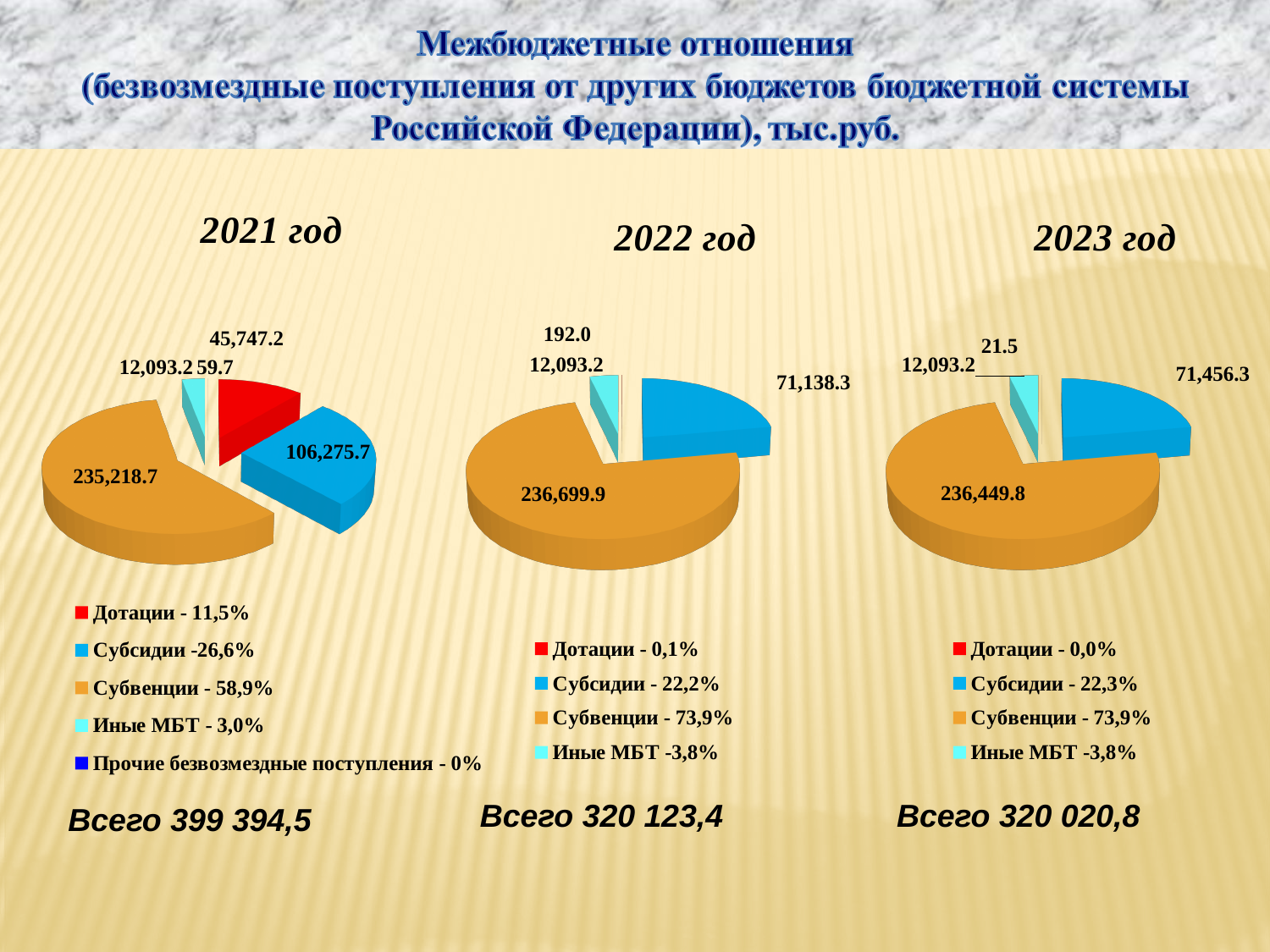
What type of charts are shown on the slide? Pie charts How many categories does the legend of the 2021 год chart list? 5 In the 2021 год chart, what is the value for Субсидии? 106,275.7 In the 2022 год chart, what share of the pie does Субвенции represent according to the legend? 73,9% In the 2023 год chart, what is the value for Субсидии? 71,456.3 In the 2021 год chart, which is larger: Дотации or Субсидии? Субсидии In the 2022 год chart, what is the value for Дотации? 192.0 In the 2021 год chart, what is the value for Субвенции? 235,218.7 In the 2021 год chart, what share of the pie does Субсидии represent according to the legend? 26,6% In the 2023 год chart, which category has the largest slice? Субвенции In the 2022 год chart, which category has the smallest slice? Дотации How many pie charts are on the slide? 3